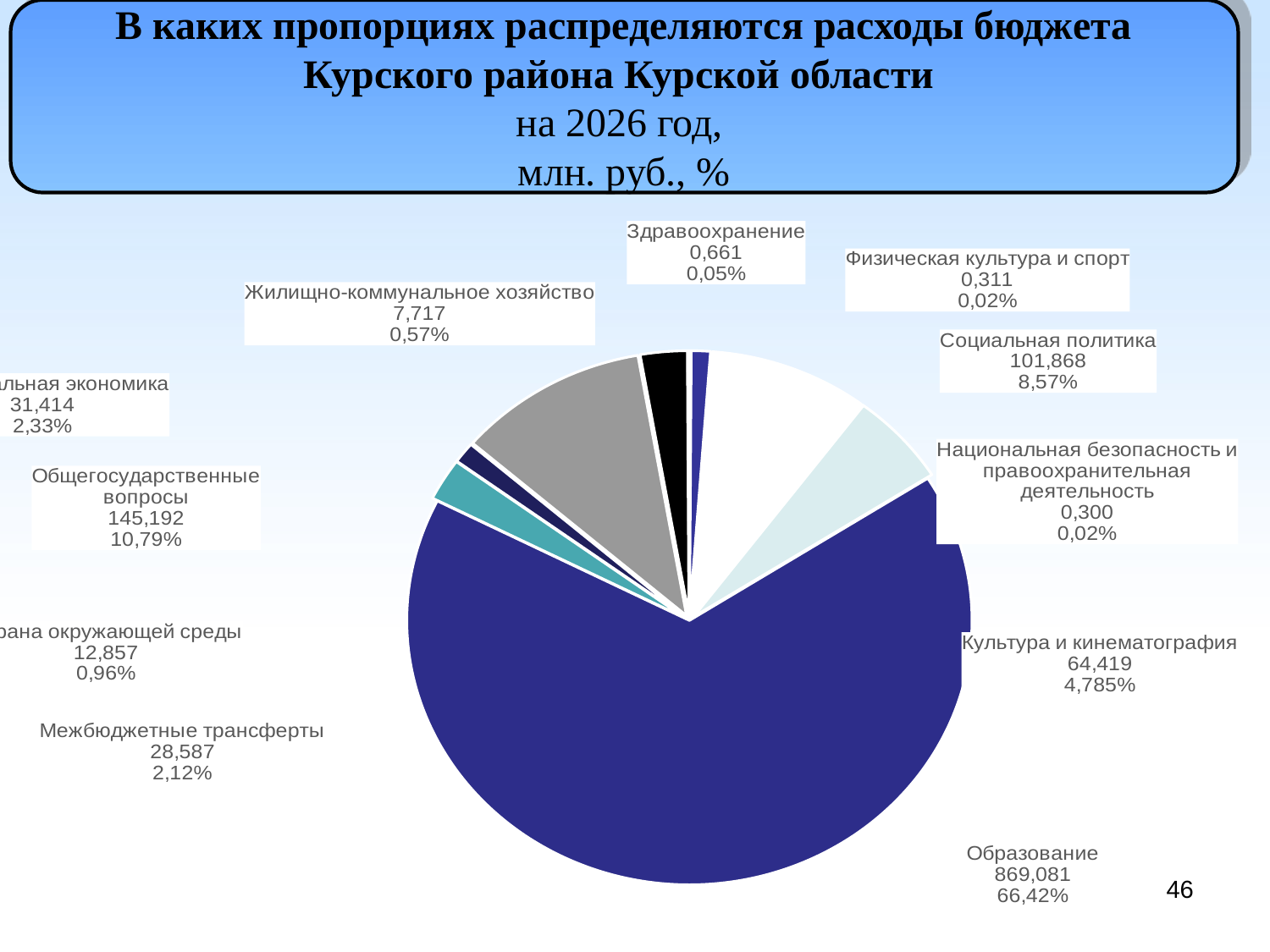
What is the value shown for Образование? 869,081 What share of the pie does Культура и кинематография account for? 4,785% What is the value shown for Межбюджетные трансферты? 28,587 Which category has the smallest value in the chart? Национальная безопасность и правоохранительная деятельность What is the difference between the values for Общегосударственные вопросы and Социальная политика? 43,324 Which is larger: Общегосударственные вопросы or Социальная политика? Общегосударственные вопросы What kind of chart is shown on the slide? pie chart Which category has the largest slice of the pie? Образование What is the value shown for Социальная политика? 101,868 How many categories are shown in the pie chart? 11 For which year does the chart show the budget expenditure distribution? 2026 What share of the pie does Образование account for? 66,42%